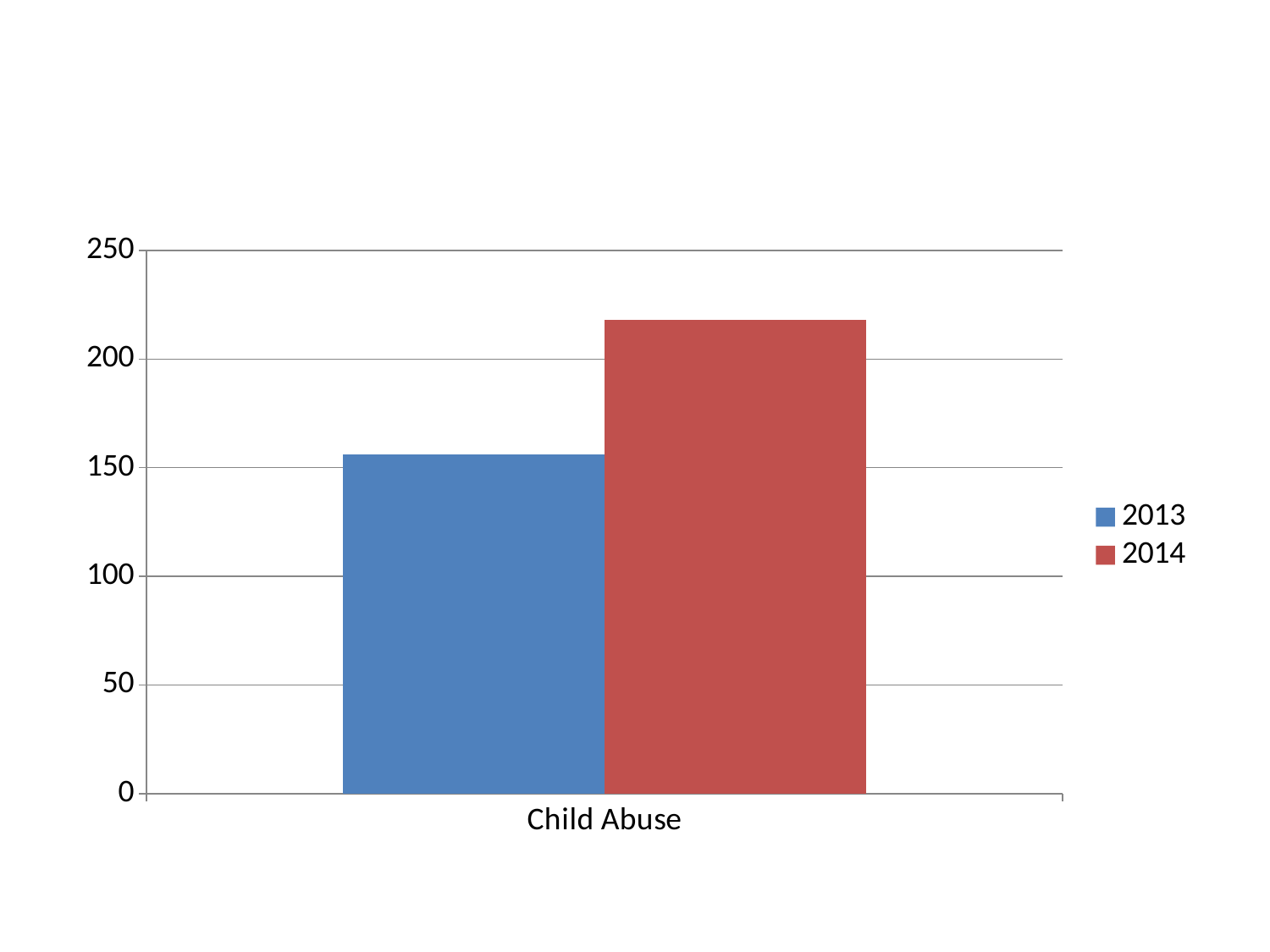
What kind of chart is shown on the slide? bar chart Is the value for 2013 for Child Abuse greater or less than 200? less What is the category label on the x axis? Child Abuse Did the value for Child Abuse rise or fall from 2013 to 2014? rise Which series has the lowest value for Child Abuse? 2013 Which series has the higher value for Child Abuse, 2013 or 2014? 2014 How many categories are shown on the x axis? 1 Is the value for 2014 for Child Abuse greater or less than 250? less Which colour represents the 2014 series in the legend? red How many series does the legend list? 2 Is the value for 2013 for Child Abuse greater or less than 150? greater